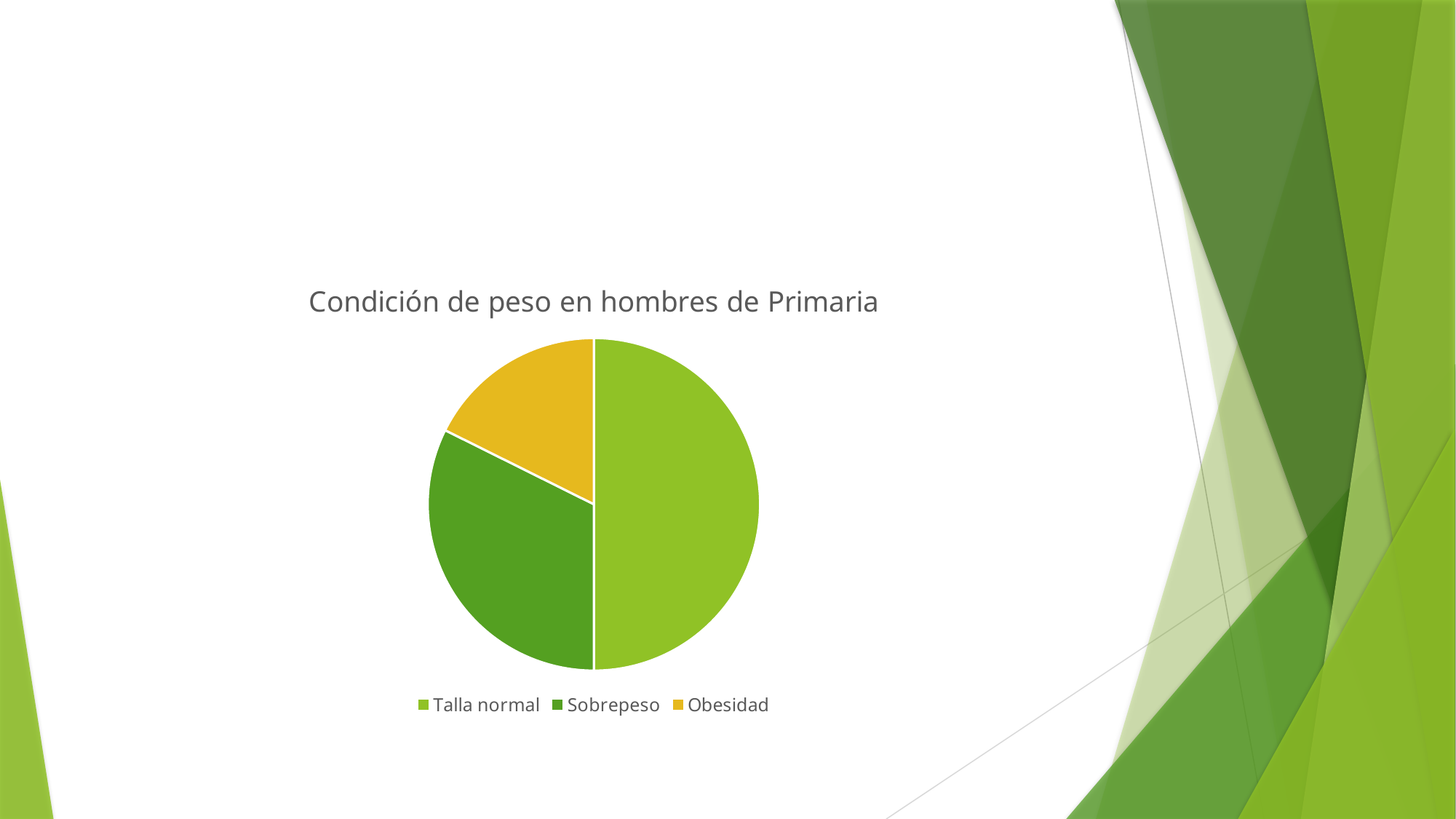
Is the share of the pie for Talla normal greater or less than 25%? greater Is the share of the pie for Obesidad greater or less than 25%? less Which category has the largest slice of the pie? Talla normal What is the title of the chart? Condición de peso en hombres de Primaria How many categories does the pie chart show? 3 Which slice is larger, Talla normal or Sobrepeso? Talla normal What kind of chart is shown on the slide? pie chart Which slice is larger, Sobrepeso or Obesidad? Sobrepeso Which category is shown in yellow in the pie chart? Obesidad Which category has the smallest slice of the pie? Obesidad